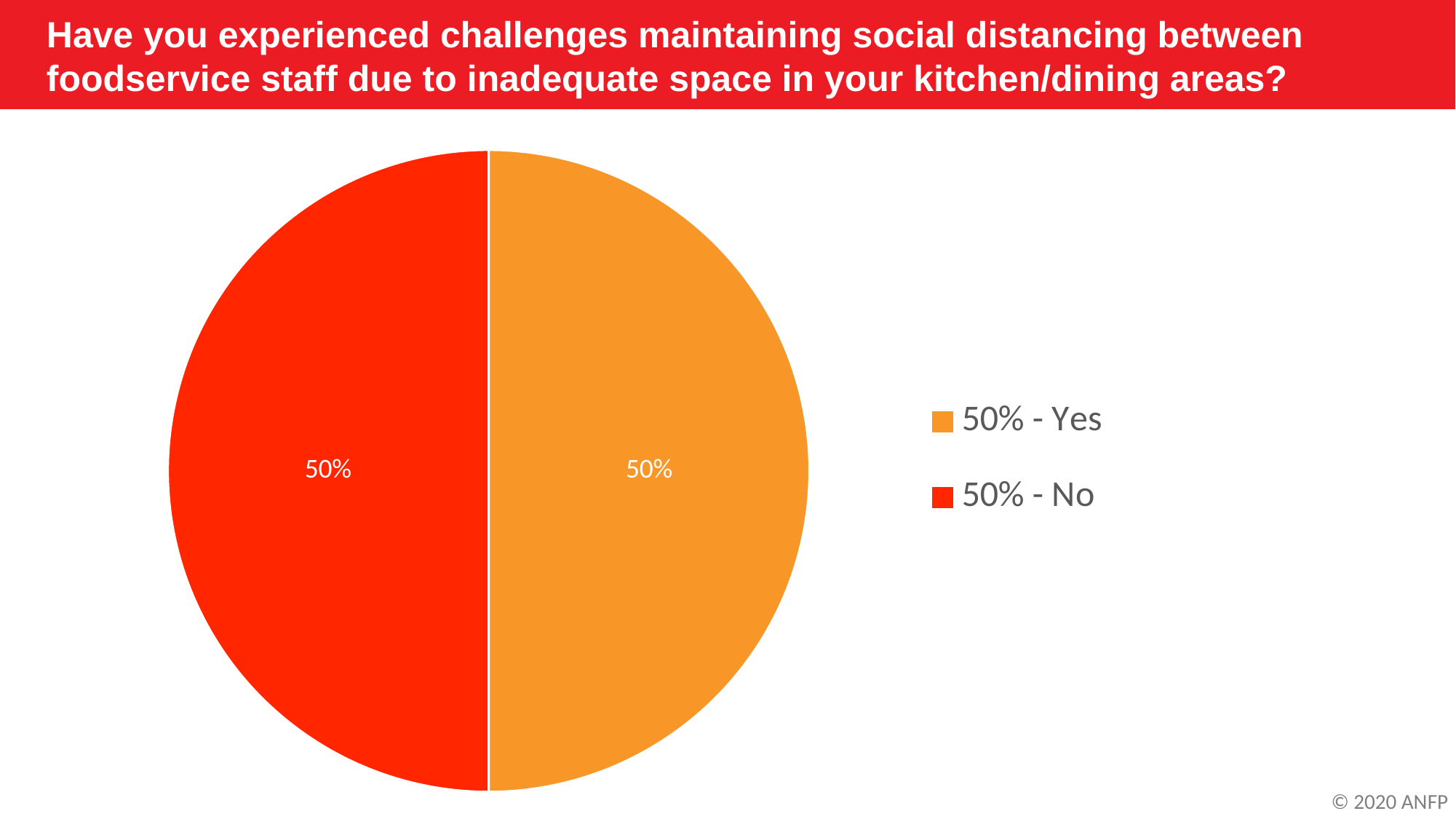
Is the share for Yes greater or less than 25%? greater How many entries does the legend list? 2 What share of respondents answered No? 50% Which colour represents the Yes slice? orange Is the share for No greater or less than 75%? less What is the combined share of the Yes and No slices? 100% What is the difference between the Yes share and the No share? 0% How many slices does the pie chart have? 2 What share of respondents answered Yes? 50% What kind of chart is shown on the slide? pie chart Which colour represents the No slice? red